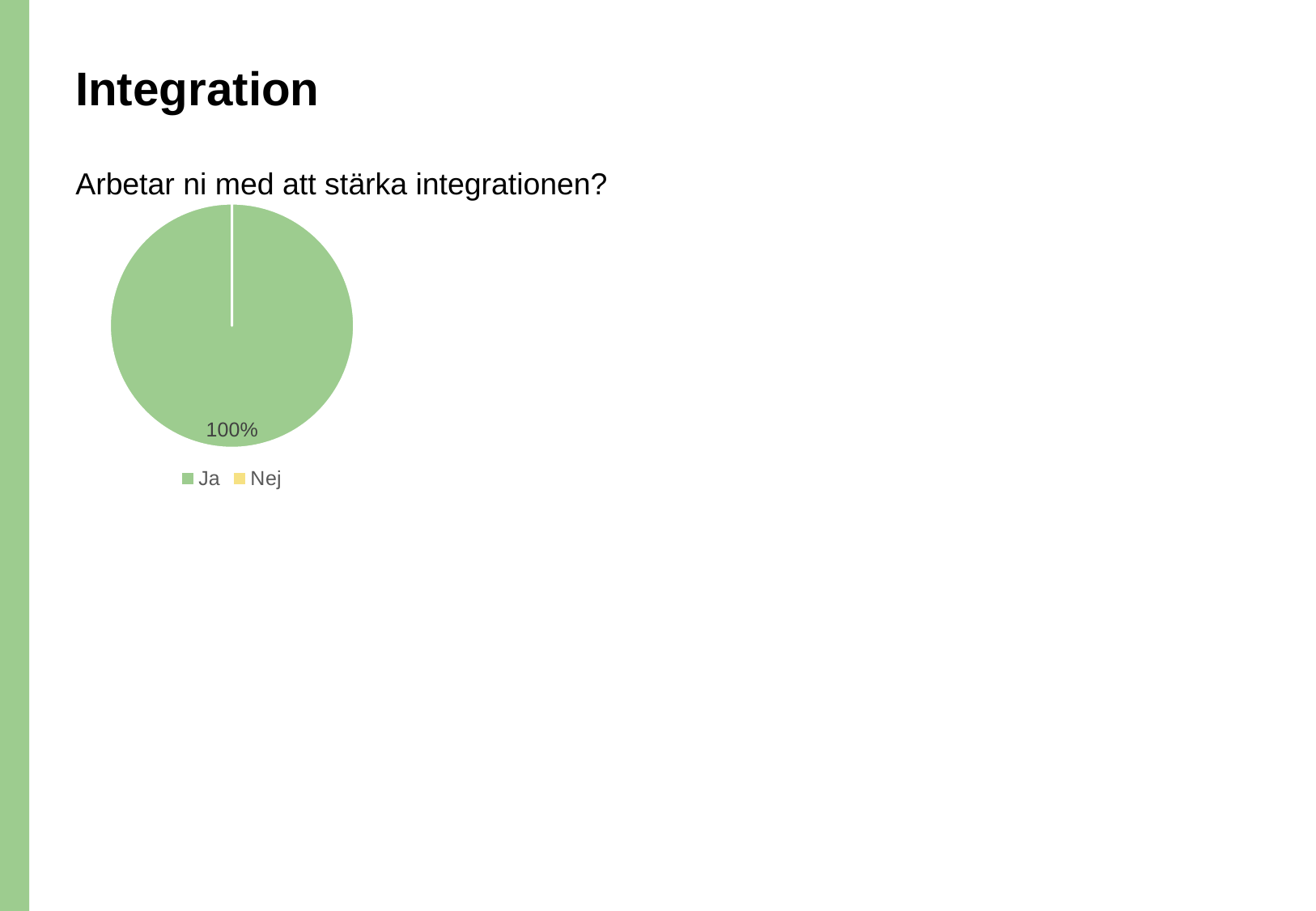
What colour represents "Ja" in the legend? green What question does the chart answer, as written above it? Arbetar ni med att stärka integrationen? What is the value printed on the pie chart? 100% Which category has the largest share of the pie? Ja Which is larger, the share for "Ja" or the share for "Nej"? Ja What share of the pie does "Ja" represent? 100% How many entries does the legend list? 2 Is the share for "Ja" greater or less than 50%? greater What kind of chart is shown on the slide? pie chart